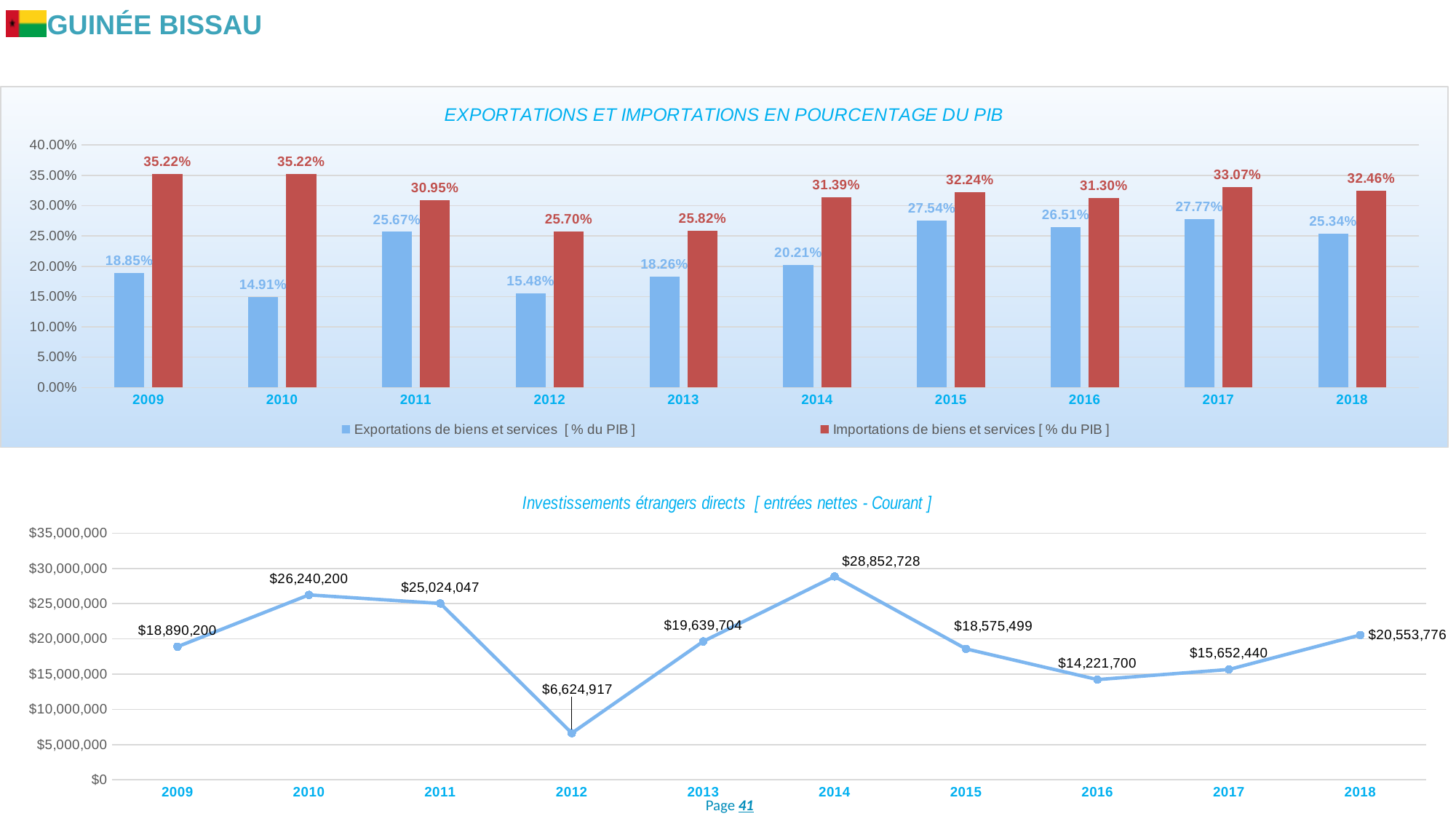
In the chart 'EXPORTATIONS ET IMPORTATIONS EN POURCENTAGE DU PIB', what type of chart is used? Bar chart In the chart 'EXPORTATIONS ET IMPORTATIONS EN POURCENTAGE DU PIB', what is the value of imports as a percentage of GDP in 2017? 33.07% In the chart 'EXPORTATIONS ET IMPORTATIONS EN POURCENTAGE DU PIB', which year has the lowest import share of GDP? 2012 In the chart 'EXPORTATIONS ET IMPORTATIONS EN POURCENTAGE DU PIB', how many series does the legend list? 2 In the chart 'Investissements étrangers directs', what is the difference between the 2010 and 2009 values? $7,350,000 In the chart 'Investissements étrangers directs', what is the value for 2013? $19,639,704 In the chart 'EXPORTATIONS ET IMPORTATIONS EN POURCENTAGE DU PIB', which year has the lowest export share of GDP? 2010 In the chart 'Investissements étrangers directs', which year has the highest value? 2014 In the chart 'EXPORTATIONS ET IMPORTATIONS EN POURCENTAGE DU PIB', what is the difference between imports and exports in 2018? 7.12% In the chart 'EXPORTATIONS ET IMPORTATIONS EN POURCENTAGE DU PIB', what is the value of exports as a percentage of GDP in 2011? 25.67% In the chart 'Investissements étrangers directs', how many years are plotted? 10 In the chart 'Investissements étrangers directs', which year has the lowest value? 2012